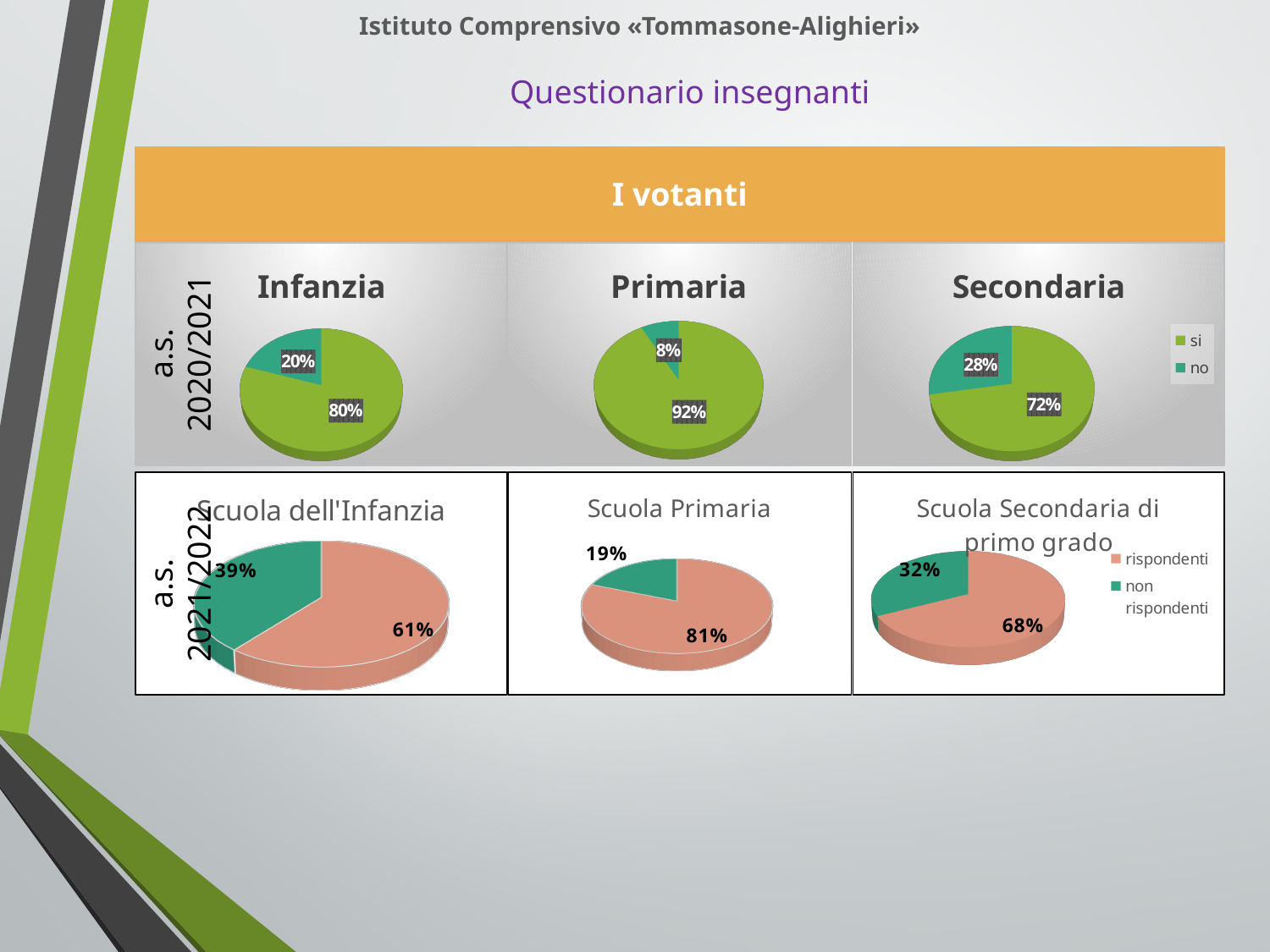
Among the three 2020/2021 pie charts, which school has the highest 'si' share? Primaria In the 2021/2022 'Scuola Primaria' pie chart, what share is 'non rispondenti'? 19% In the 2020/2021 'Infanzia' pie chart, what share is labelled 'si'? 80% In the 2020/2021 'Primaria' pie chart, what share is labelled 'no'? 8% Among the three 2021/2022 pie charts, which school has the lowest 'rispondenti' share? Scuola dell'Infanzia How many entries does the legend of the 2021/2022 charts list? 2 Which is larger: the 'no' share in the 2020/2021 'Infanzia' chart or the 'non rispondenti' share in the 2021/2022 'Scuola dell'Infanzia' chart? non rispondenti in Scuola dell'Infanzia (39%) What type of chart is used for the 2021/2022 'Scuola Primaria' data? pie chart In the 2020/2021 'Secondaria' pie chart, what is the difference between the 'si' and 'no' shares? 44%